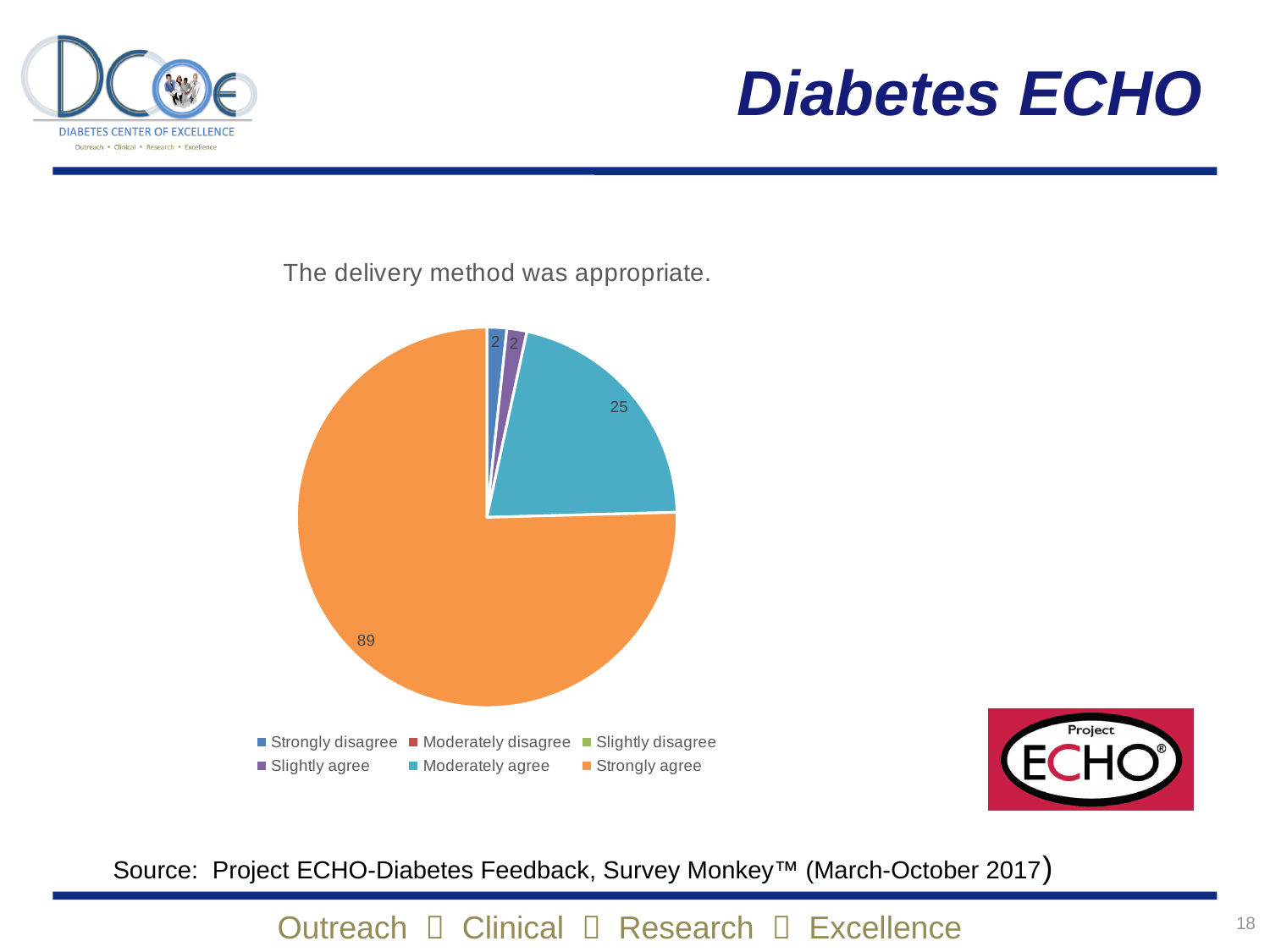
What is the difference between the values for Strongly agree and Moderately agree? 64 What colour is the Strongly agree slice in the pie chart? Orange What is the total of the labelled slice values in the pie chart? 118 What is the value for Strongly disagree in the pie chart? 2 Which category has the largest slice in the pie chart? Strongly agree What kind of chart is shown on the slide? Pie chart Which is larger, the value for Moderately agree or the value for Slightly agree? Moderately agree How many series does the legend list? 6 What is the title of the chart? The delivery method was appropriate. What is the value for Moderately agree in the pie chart? 25 What is the value for Strongly agree in the pie chart? 89 What is the value for Slightly agree in the pie chart? 2